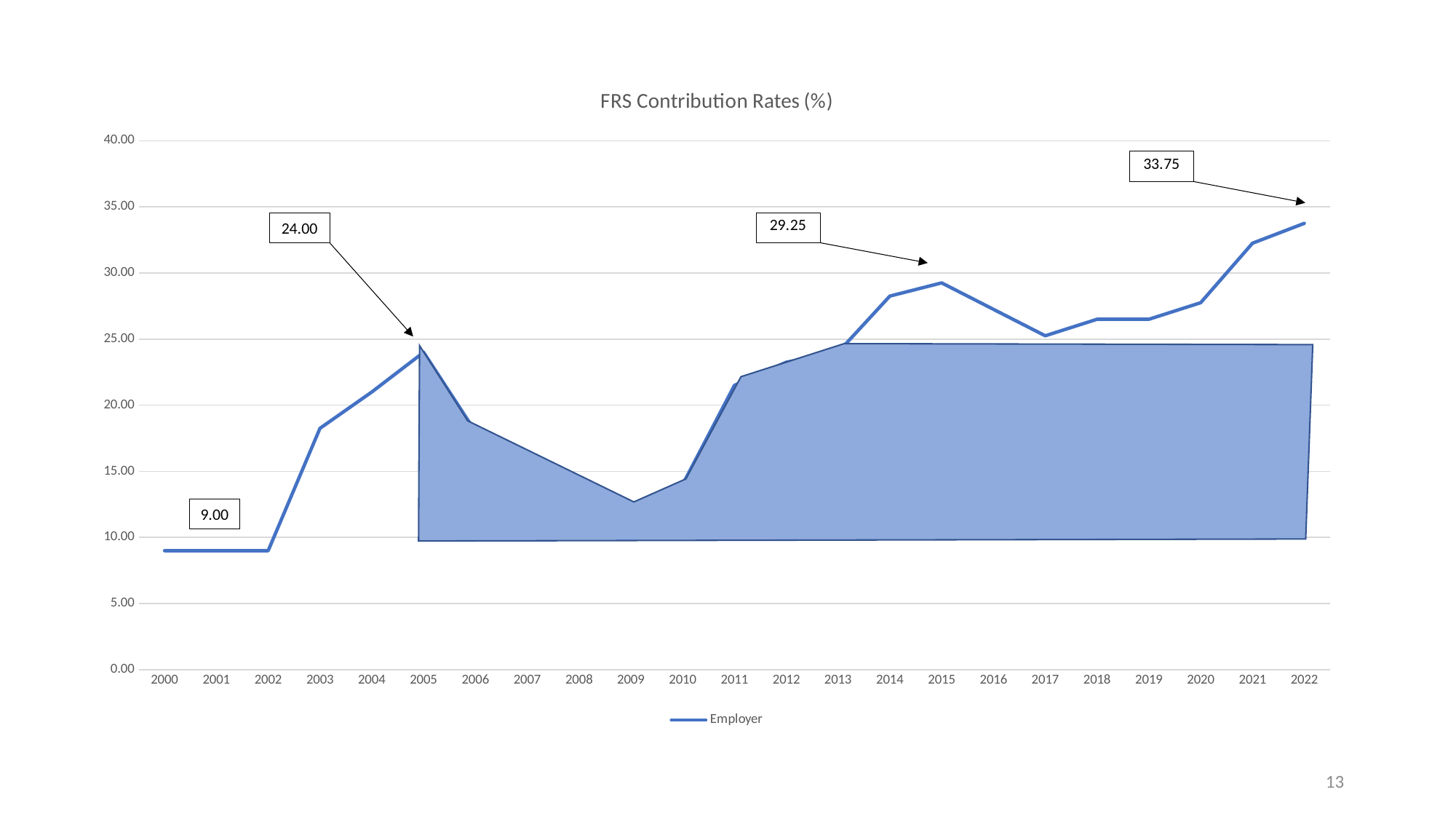
How many series does the legend list? 1 Is the Employer rate for 2009 greater or less than 15.00? less What is the Employer contribution rate for 2005? 24.00 What is the title of the chart? FRS Contribution Rates (%) What type of chart is shown on the slide? line chart Does the Employer rate rise or fall from 2005 to 2009? fall What is the Employer contribution rate for 2015? 29.25 What is the difference between the Employer rate in 2022 and in 2005? 9.75 What is the Employer contribution rate for 2022? 33.75 How many years are plotted along the x axis? 23 Which year has the highest Employer contribution rate? 2022 Which is larger, the Employer rate in 2015 or in 2022? 2022